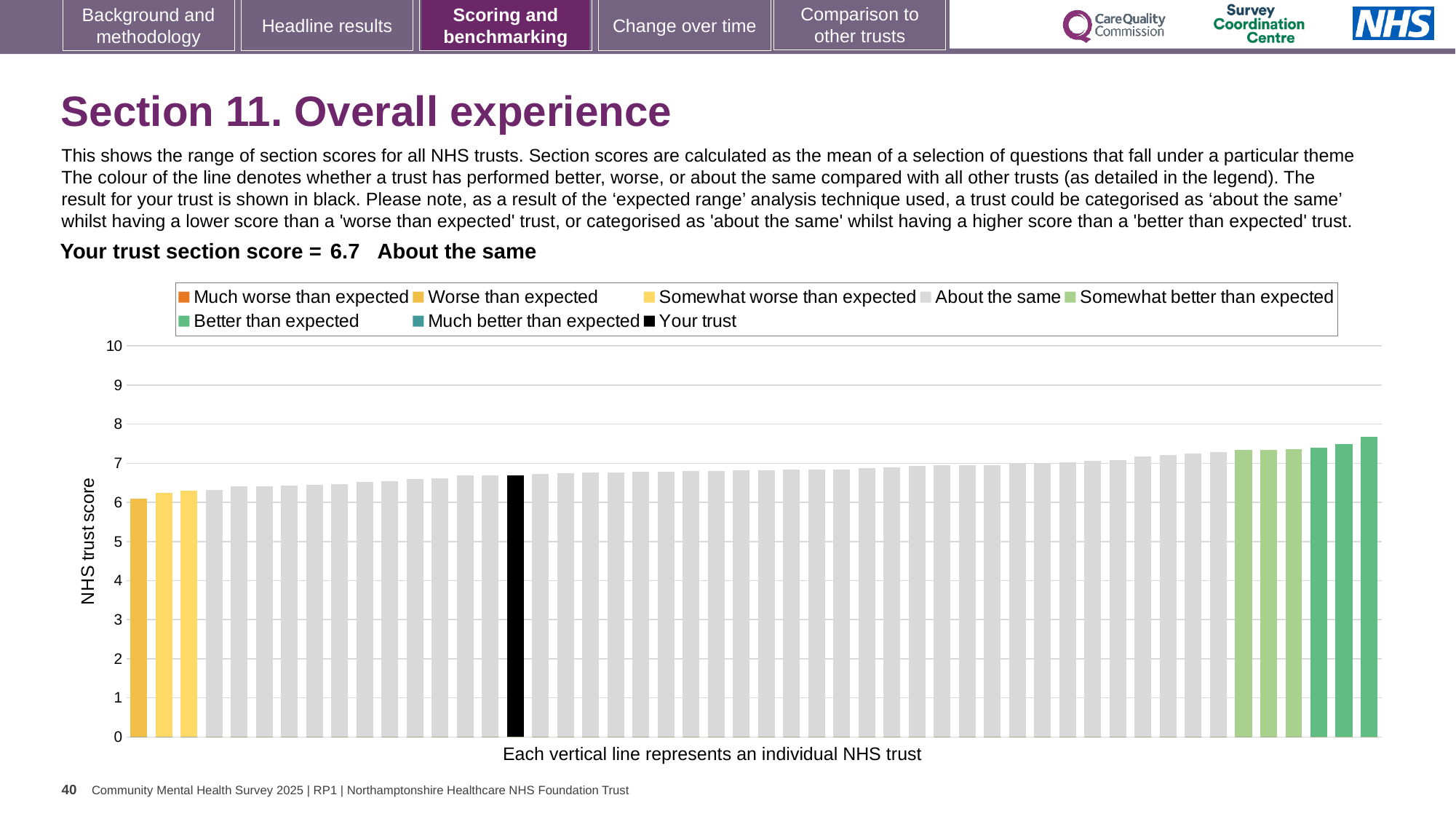
Is the value of the rightmost bar greater or less than 8? less How many entries does the chart legend list? 8 Is the value of the black bar (your trust) greater or less than 6? greater Do the bar values rise or fall from left to right along the x axis? rise Is the value of the leftmost bar greater or less than 7? less According to the legend, what colour represents your trust? black Which is higher, the black bar for your trust or the rightmost bar? the rightmost bar What is the label on the vertical axis of the chart? NHS trust score What is the section score for your trust, as printed on the slide? 6.7 How is your trust's section score categorised compared with other trusts? About the same What kind of chart is shown on the slide? bar chart